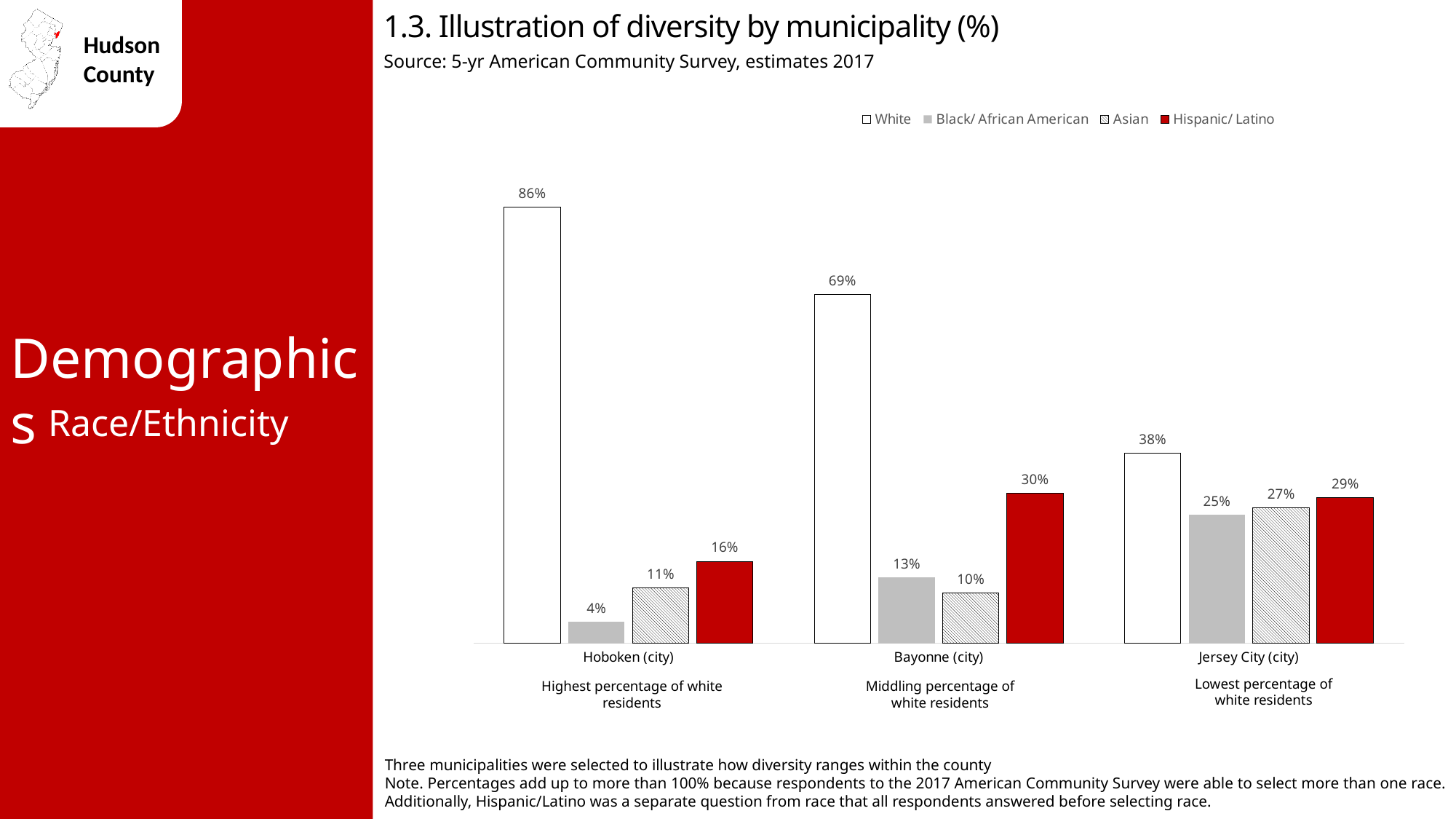
What is the Black/ African American percentage for Hoboken (city)? 4% What is the White percentage for Hoboken (city)? 86% What is the difference between the White percentage in Hoboken (city) and in Jersey City (city)? 48% What kind of chart is shown on the slide? Bar chart Which municipality has the lowest Black/ African American percentage? Hoboken (city) Which is larger: the Asian percentage in Bayonne (city) or the Black/ African American percentage in Bayonne (city)? Black/ African American What is the Asian percentage for Jersey City (city)? 27% How many municipalities are shown on the x axis? 3 What is the Hispanic/ Latino percentage for Bayonne (city)? 30% What colour are the Hispanic/ Latino bars? Red Which municipality has the highest White percentage? Hoboken (city) How many series does the legend list? 4